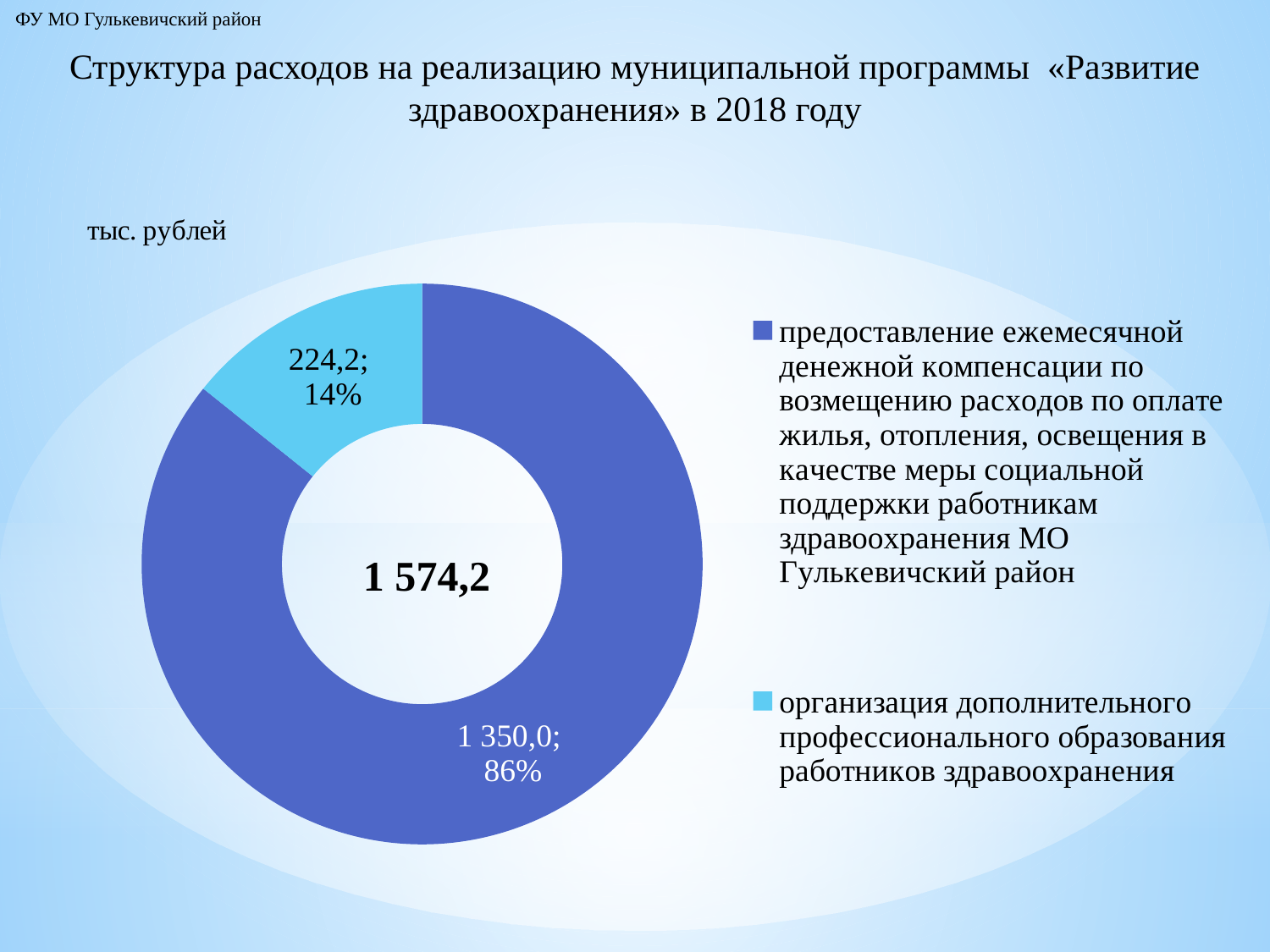
Which category has the smallest value? организация дополнительного профессионального образования работников здравоохранения How many categories does the chart show? 2 What kind of chart is shown on the slide? Doughnut (pie) chart What is the value for «организация дополнительного профессионального образования работников здравоохранения»? 224,2 In what units are the chart values given? тыс. рублей What share of the chart does the monthly compensation for housing, heating and lighting costs («предоставление ежемесячной денежной компенсации...») take? 86% What is the value for «предоставление ежемесячной денежной компенсации по возмещению расходов по оплате жилья, отопления, освещения...»? 1 350,0 Which category has the largest value? предоставление ежемесячной денежной компенсации по возмещению расходов по оплате жилья, отопления, освещения What total is shown in the centre of the chart? 1 574,2 What share of the chart does «организация дополнительного профессионального образования работников здравоохранения» take? 14% What is the difference between the two values shown on the chart (1 350,0 and 224,2)? 1 125,8 Which is larger: the value for «организация дополнительного профессионального образования» or the value for «предоставление ежемесячной денежной компенсации»? предоставление ежемесячной денежной компенсации